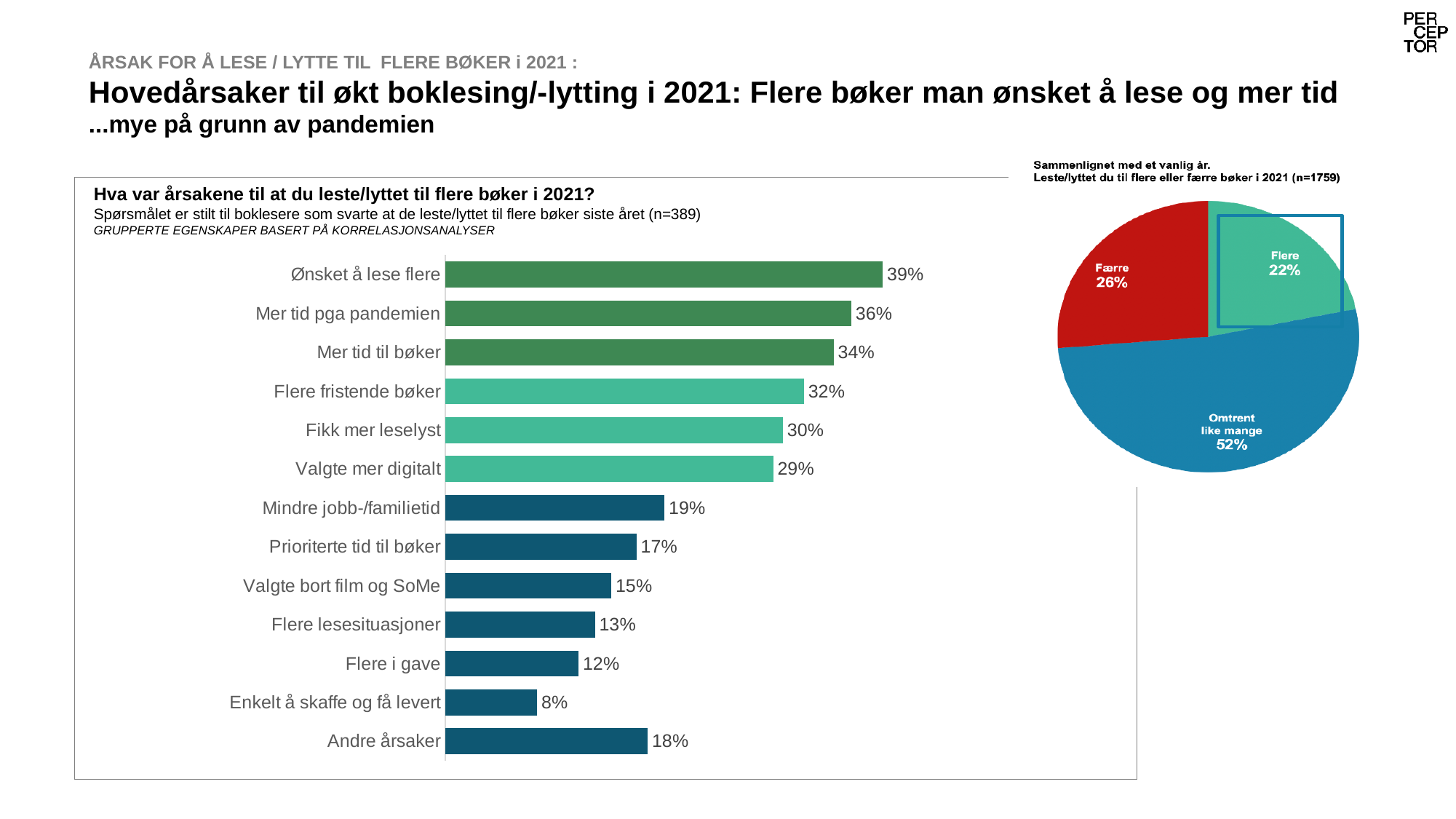
How many categories are shown in the bar chart on the left? 13 What kind of chart is the chart on the right? Pie chart In the pie chart on the right, what is the value for "Færre"? 26% In the bar chart on the left, which category has the highest value? Ønsket å lese flere In the bar chart on the left, what is the difference between "Ønsket å lese flere" and "Mer tid til bøker"? 5% In the bar chart on the left, which category has the lowest value? Enkelt å skaffe og få levert In the bar chart on the left, what is the value for "Mer tid pga pandemien"? 36% In the bar chart on the left, what is the value for "Valgte bort film og SoMe"? 15% What kind of chart is the chart on the left? Bar chart In the bar chart on the left, which is larger: "Fikk mer leselyst" or "Mindre jobb-/familietid"? Fikk mer leselyst In the pie chart on the right, which slice is the smallest? Flere In the pie chart on the right, what share is "Omtrent like mange"? 52%